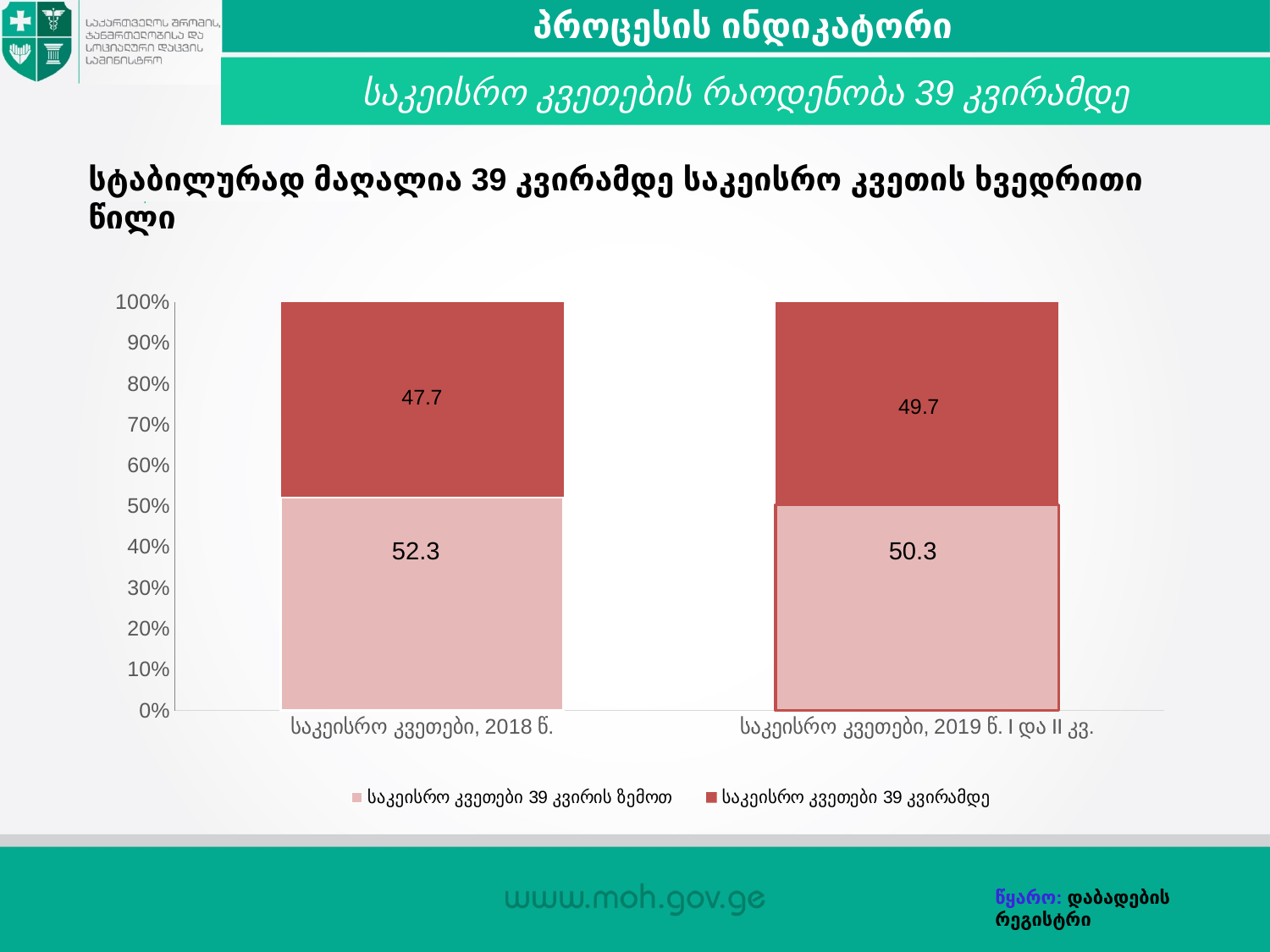
Does the value for "საკეისრო კვეთები 39 კვირამდე" rise or fall from 2018 to 2019? Rise What is the difference between the "საკეისრო კვეთები 39 კვირამდე" values for 2019 and 2018? 2.0 Which category has the lower value for "საკეისრო კვეთები 39 კვირის ზემოთ"? საკეისრო კვეთები, 2019 წ. I და II კვ. What is the value for "საკეისრო კვეთები 39 კვირის ზემოთ" in the "საკეისრო კვეთები, 2018 წ." bar? 52.3 What is the value for "საკეისრო კვეთები 39 კვირის ზემოთ" in the "საკეისრო კვეთები, 2019 წ. I და II კვ." bar? 50.3 What is the value for "საკეისრო კვეთები 39 კვირამდე" in the "საკეისრო კვეთები, 2019 წ. I და II კვ." bar? 49.7 What kind of chart is shown on the slide? Stacked bar chart In the 2018 bar, which is larger: "საკეისრო კვეთები 39 კვირის ზემოთ" or "საკეისრო კვეთები 39 კვირამდე"? საკეისრო კვეთები 39 კვირის ზემოთ What is the value for "საკეისრო კვეთები 39 კვირამდე" in the "საკეისრო კვეთები, 2018 წ." bar? 47.7 Which category has the higher value for "საკეისრო კვეთები 39 კვირამდე"? საკეისრო კვეთები, 2019 წ. I და II კვ. How many series does the legend list? 2 How many categories are shown on the x axis of the chart? 2